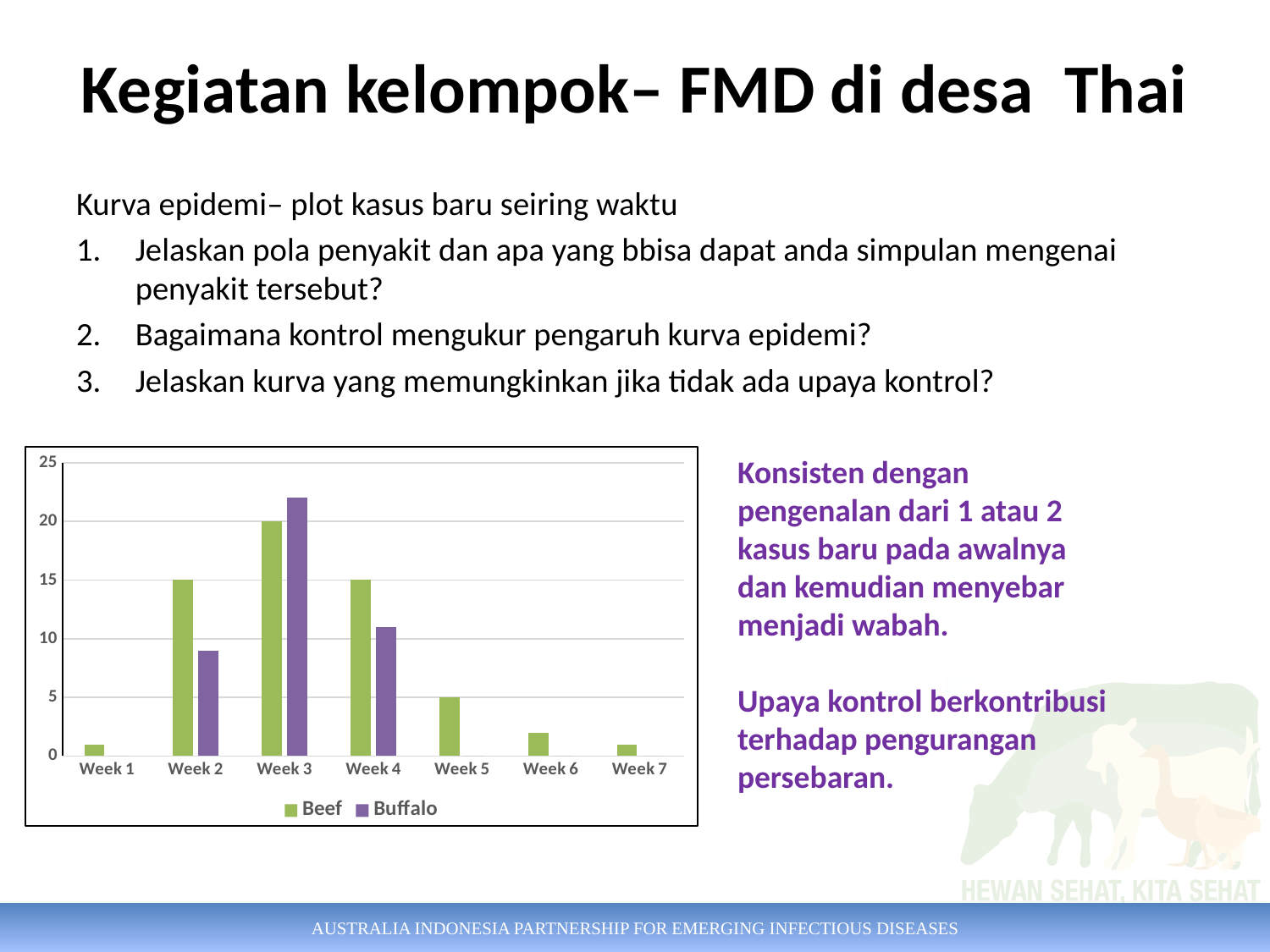
Is the Buffalo value for Week 2 greater or less than 10? less What is the Beef value for Week 5? 5 What is the Beef value for Week 3? 20 Is the Buffalo value for Week 3 greater or less than 20? greater How many weeks are shown on the x axis of the chart? 7 What kind of chart is shown on the slide? bar chart In which week is the Buffalo value highest? Week 3 Which series is shown in purple in the chart? Buffalo In which week is the Beef value highest? Week 3 What is the Beef value for Week 2? 15 How many series does the chart legend list? 2 Which is larger in Week 4, the Beef value or the Buffalo value? Beef